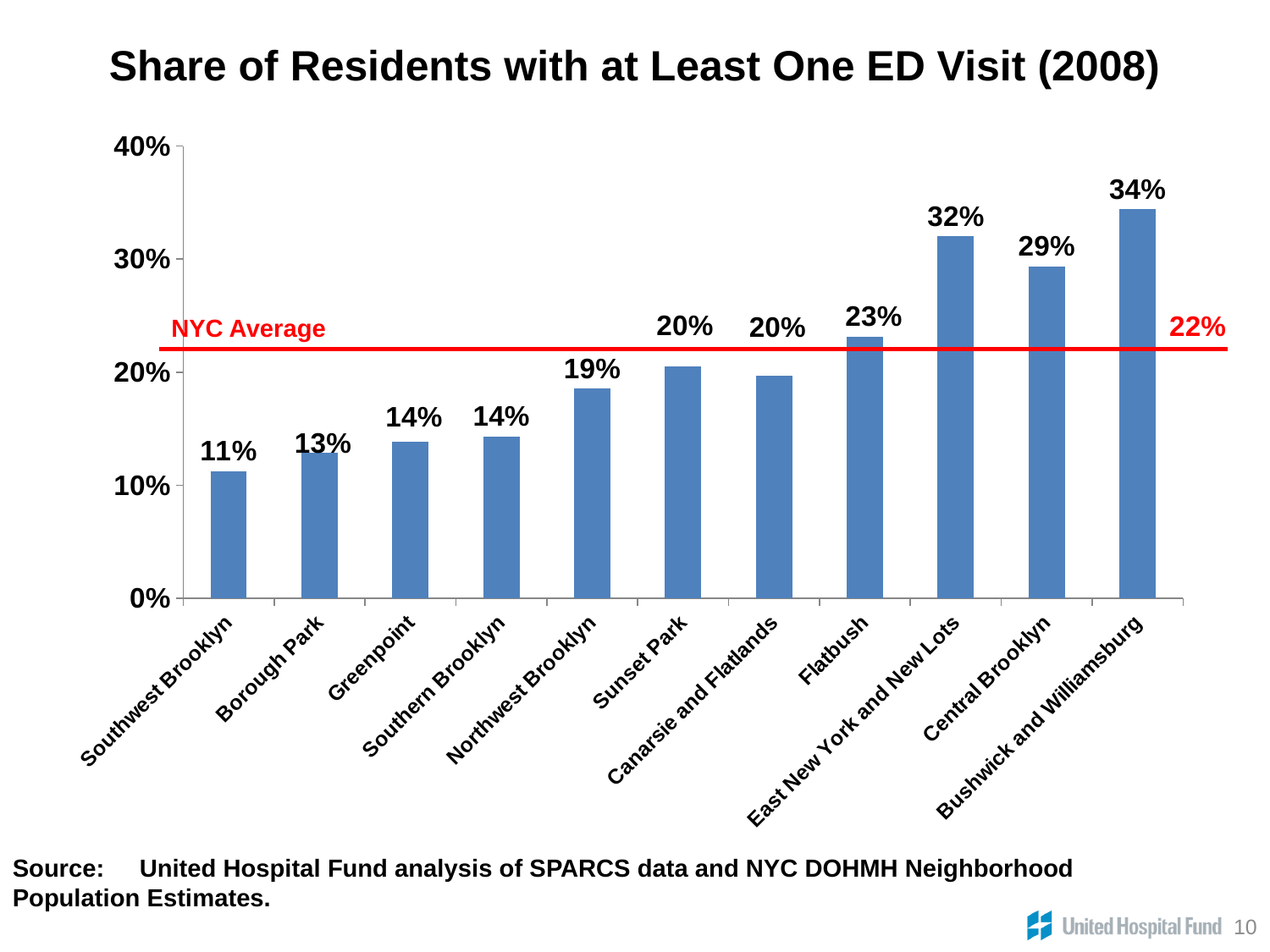
Which neighborhood has the lowest share of residents with at least one ED visit? Southwest Brooklyn What is the value shown for East New York and New Lots? 32% How many neighborhoods are shown on the chart? 11 What is the value shown for Northwest Brooklyn? 19% Is the value for Borough Park greater or less than 20%? less What is the share of residents with at least one ED visit in Flatbush? 23% Which neighborhood has the highest share of residents with at least one ED visit? Bushwick and Williamsburg Do the values rise or fall from left to right along the x axis? rise What is the difference between the values for Bushwick and Williamsburg and Southwest Brooklyn? 23% What value is labeled for the NYC Average line? 22% Which has a larger value, Central Brooklyn or Sunset Park? Central Brooklyn What kind of chart is shown on the slide? bar chart